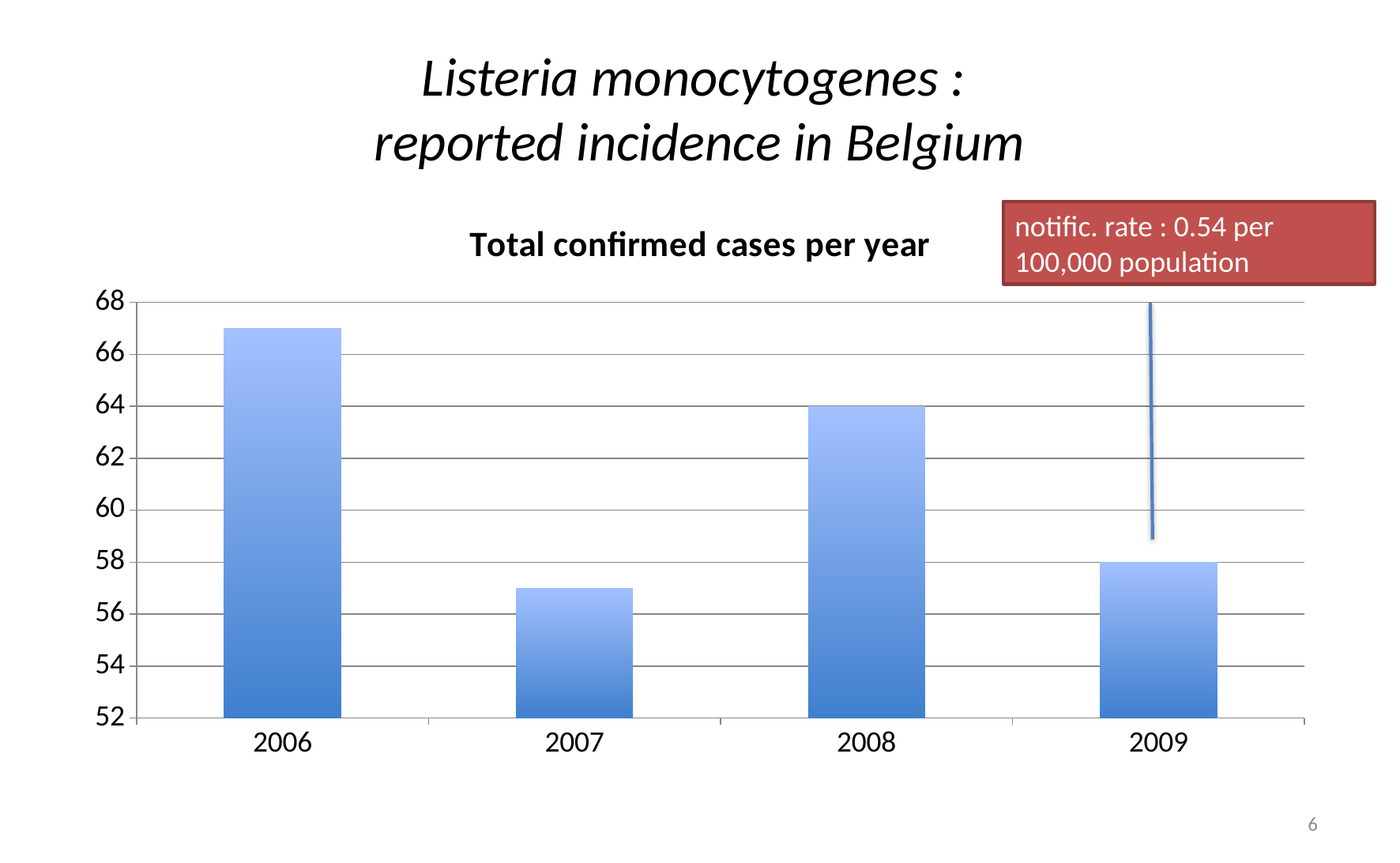
What kind of chart is shown on the slide? bar chart Did the number of total confirmed cases rise or fall from 2006 to 2007? fall Which year has the lowest number of total confirmed cases? 2007 Is the value for 2007 greater or less than 58? less Which year has the highest number of total confirmed cases? 2006 Which year has more total confirmed cases, 2006 or 2008? 2006 What is the number of total confirmed cases in 2009? 58 What is the difference between the total confirmed cases in 2008 and 2009? 6 Is the value for 2006 greater or less than 66? greater How many years are plotted in the chart? 4 What is the number of total confirmed cases in 2008? 64 What is the title of the chart? Total confirmed cases per year